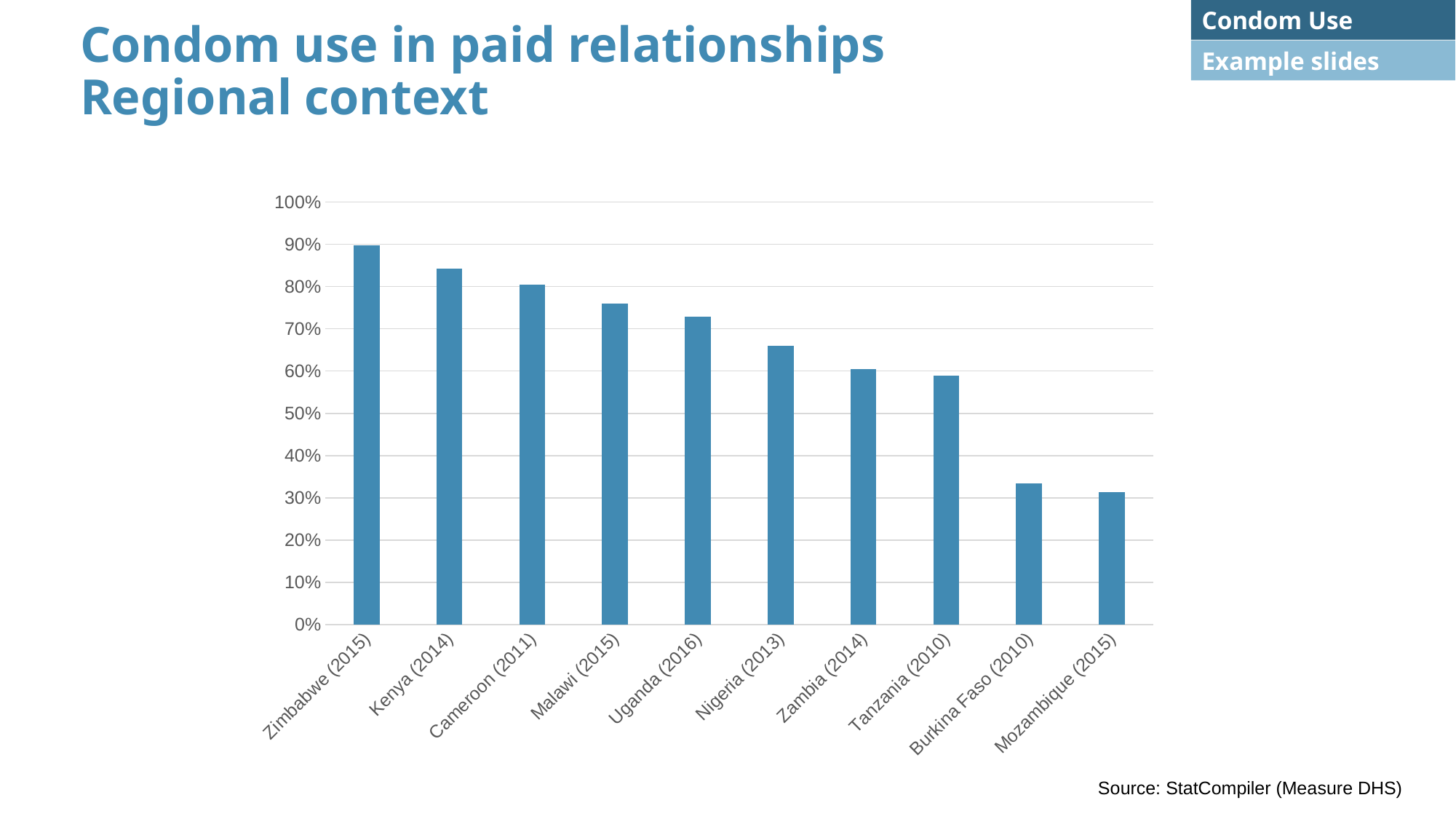
Is the value for Tanzania (2010) greater or less than 50%? greater Which is larger, the value for Uganda (2016) or the value for Zambia (2014)? Uganda (2016) What is the source cited for the chart data? StatCompiler (Measure DHS) Is the value for Kenya (2014) greater or less than 80%? greater How many countries are shown on the chart? 10 Do the values rise or fall from left to right across the chart? fall Is the value for Malawi (2015) greater or less than 70%? greater What kind of chart is shown on the slide? bar chart Which country has the lowest condom use in paid relationships? Mozambique (2015) Which country has the highest condom use in paid relationships? Zimbabwe (2015)